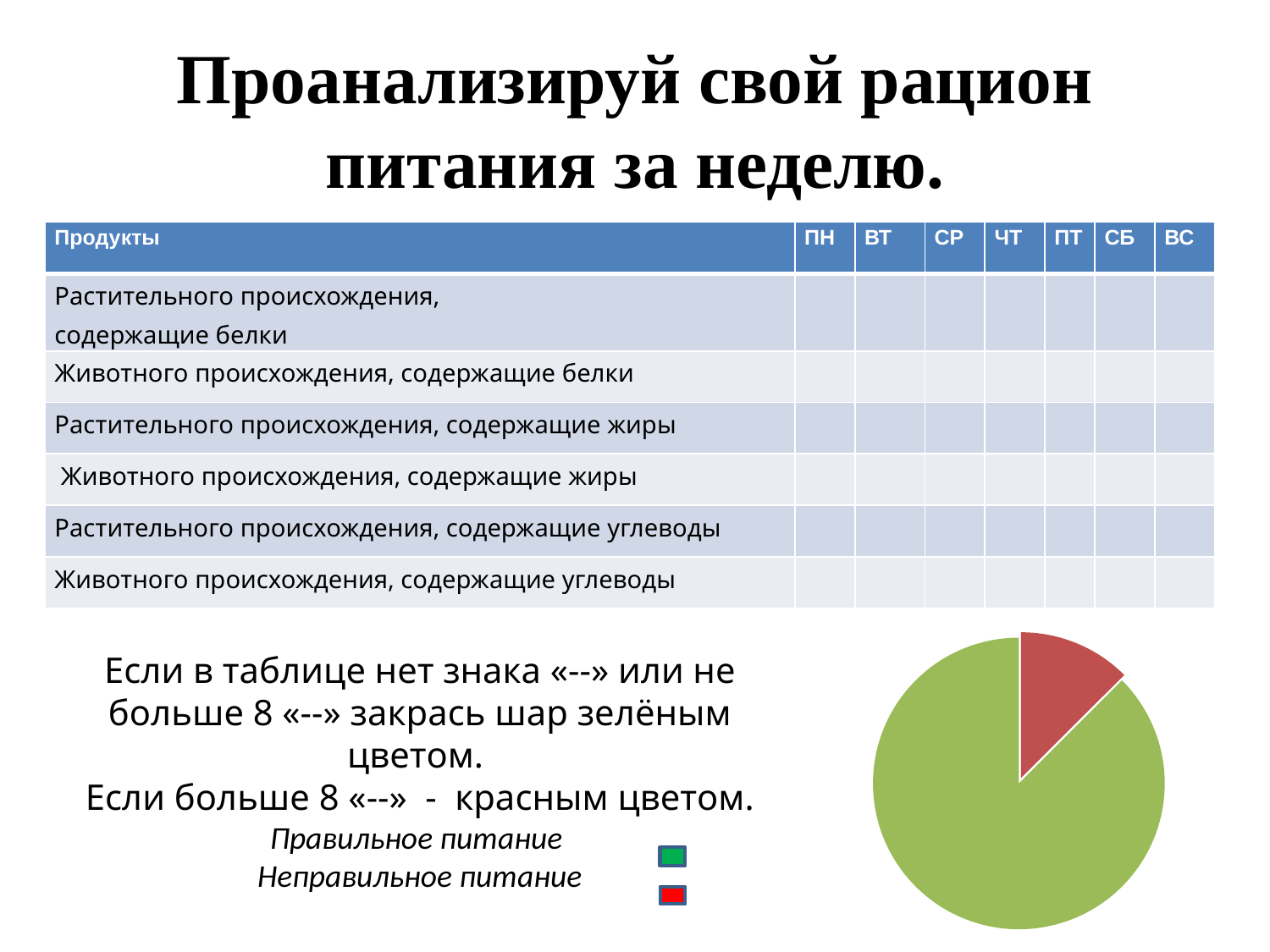
Which slice of the pie chart is the largest? the green slice What two colours are used for the slices of the pie chart? green and red Which slice of the pie chart is the smallest? the red slice Does the green slice take up more or less than half of the pie chart? more Which is larger in the pie chart, the green slice or the red slice? the green slice What kind of chart is shown at the bottom right of the slide? pie chart How many slices does the pie chart have? 2 Does the pie chart display any data labels or percentages on its slices? No